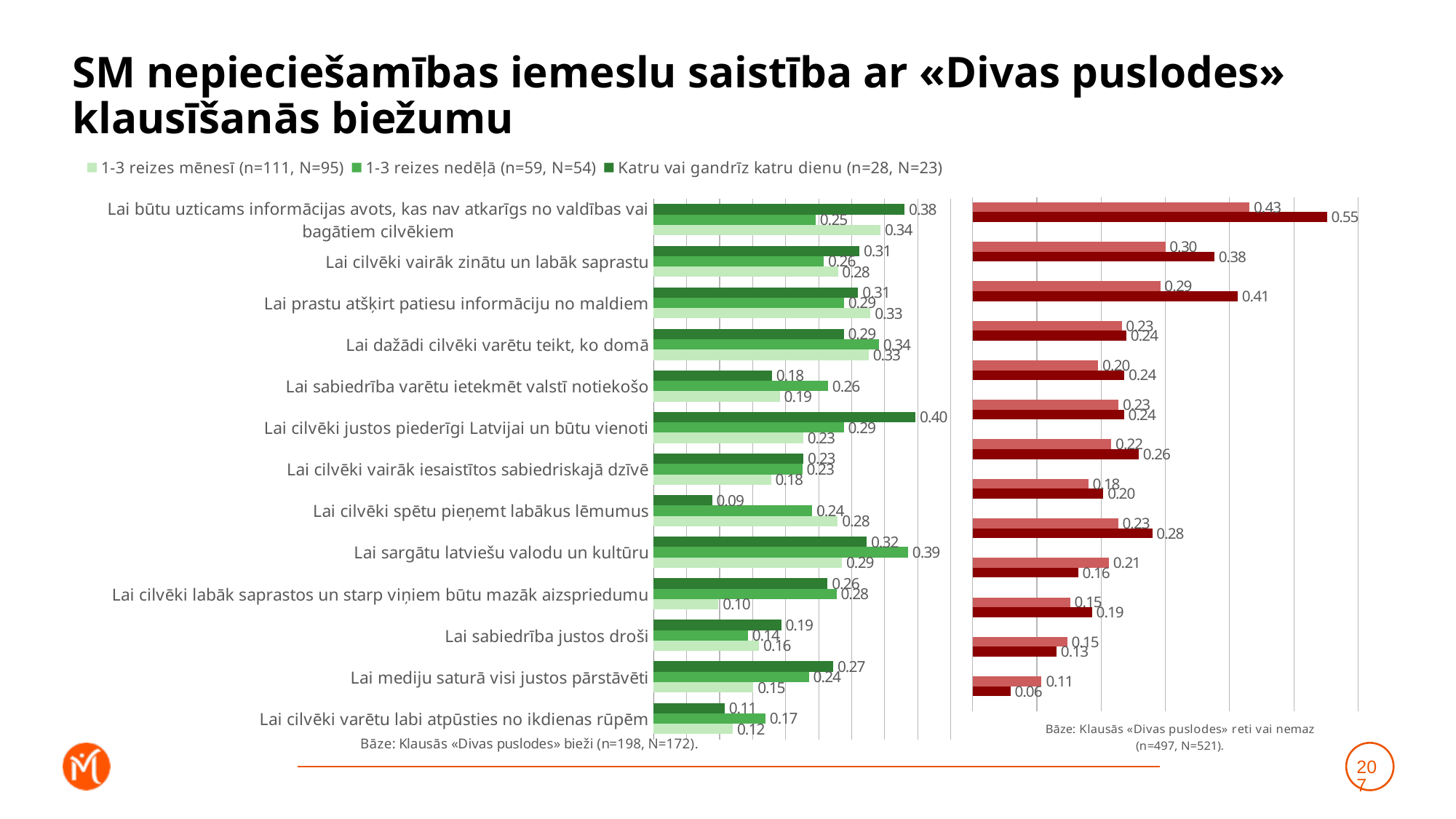
In the right (red) chart, what is the value of the darker red bar for "Lai cilvēki varētu labi atpūsties no ikdienas rūpēm"? 0.06 How many categories are shown in the left (green) chart? 13 In the left (green) chart, which category has the lowest value for "Katru vai gandrīz katru dienu"? Lai cilvēki spētu pieņemt labākus lēmumus In the left (green) chart, what is the value for "1-3 reizes mēnesī" for "Lai cilvēki labāk saprastos un starp viņiem būtu mazāk aizspriedumu"? 0.10 In the left (green) chart, for "Lai sabiedrība varētu ietekmēt valstī notiekošo", which is larger: the "1-3 reizes nedēļā" value or the "Katru vai gandrīz katru dienu" value? 1-3 reizes nedēļā What type of chart is used on this slide? Bar chart In the left (green) chart, what is the value for "Katru vai gandrīz katru dienu" for "Lai cilvēki justos piederīgi Latvijai un būtu vienoti"? 0.40 In the right (red) chart, what is the difference between the darker red bar and the lighter red bar for "Lai prastu atšķirt patiesu informāciju no maldiem"? 0.12 In the right (red) chart, what is the value of the darker red bar for "Lai būtu uzticams informācijas avots, kas nav atkarīgs no valdības vai bagātiem cilvēkiem"? 0.55 How many series does the legend of the left (green) chart list? 3 In the left (green) chart, what is the value for "1-3 reizes nedēļā" for "Lai sargātu latviešu valodu un kultūru"? 0.39 In the left (green) chart, what is the difference between the "1-3 reizes mēnesī" and "Katru vai gandrīz katru dienu" values for "Lai cilvēki spētu pieņemt labākus lēmumus"? 0.19